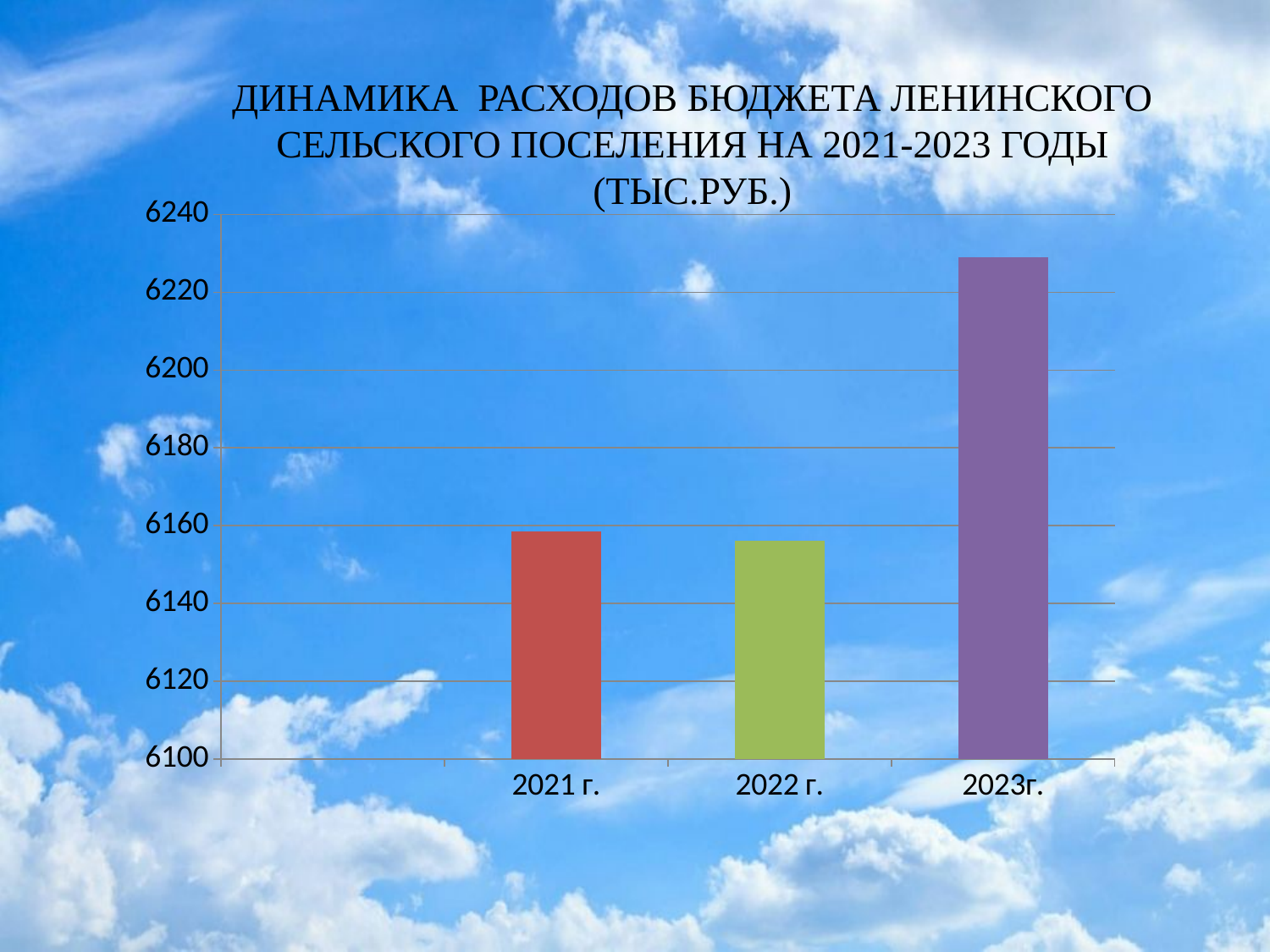
Is the value for 2023г. greater or less than 6240? less Is the value for 2023г. greater or less than 6220? greater In what units are the values in the chart expressed, according to the title? тыс.руб. Does the value rise or fall from 2022 г. to 2023г.? rise How many bars (years) are plotted in the chart? 3 Which year has the highest budget expenditure in the chart? 2023г. What is the lowest value shown on the vertical axis? 6100 Is the value for 2022 г. greater or less than 6180? less What kind of chart is shown on the slide? bar chart Which is larger, the value for 2021 г. or the value for 2023г.? 2023г.